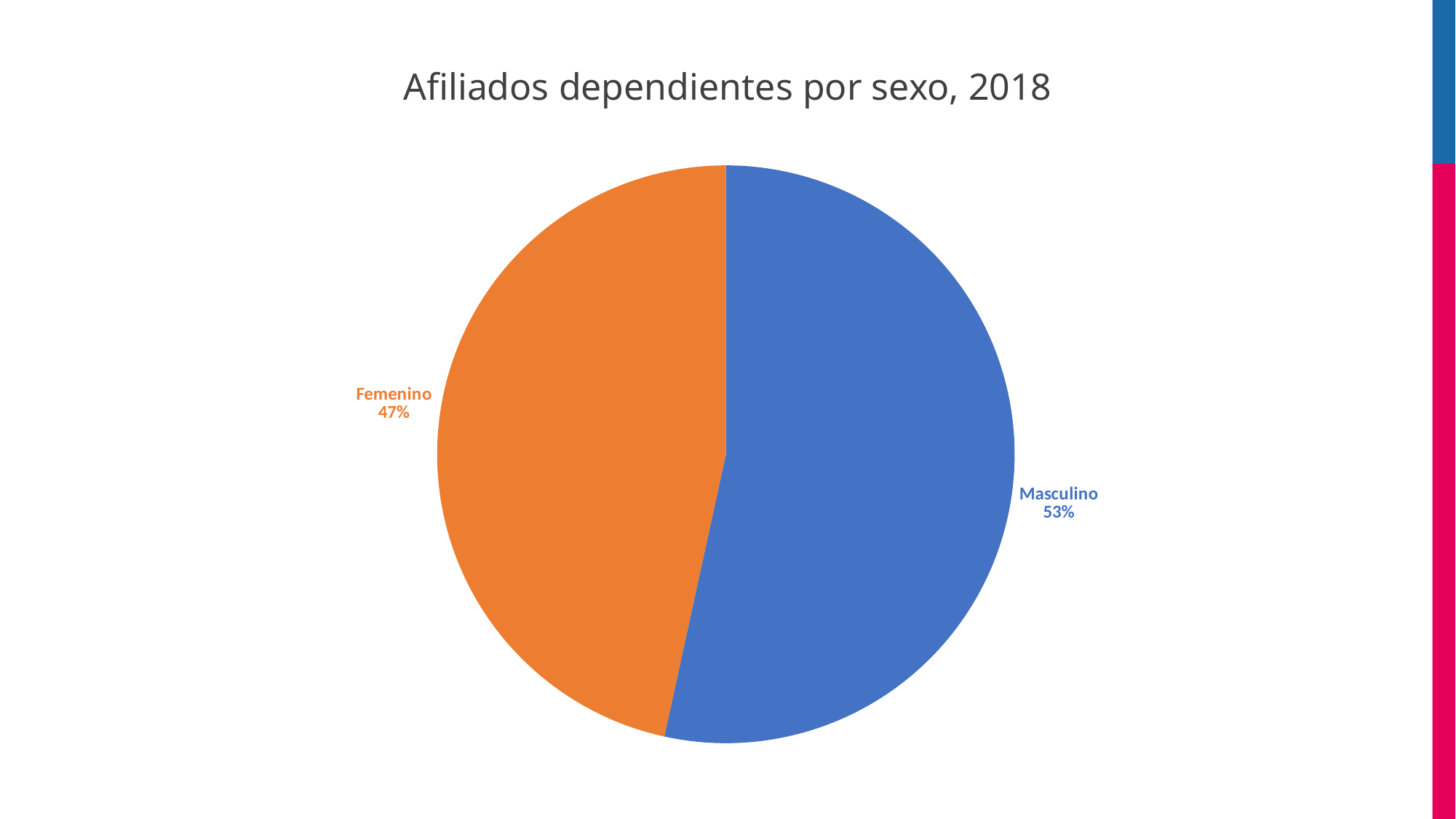
What colour is the Femenino slice? orange Which is larger, the Femenino slice or the Masculino slice? Masculino What is the title of the chart? Afiliados dependientes por sexo, 2018 Which category has the largest slice of the pie? Masculino Which category has the smallest slice of the pie? Femenino What is the total of the two slices' percentages? 100% What share of the pie does Masculino represent? 53% What is the difference in percentage points between Masculino and Femenino? 6 How many slices does the pie chart have? 2 What share of the pie does Femenino represent? 47% What kind of chart is shown on the slide? pie chart